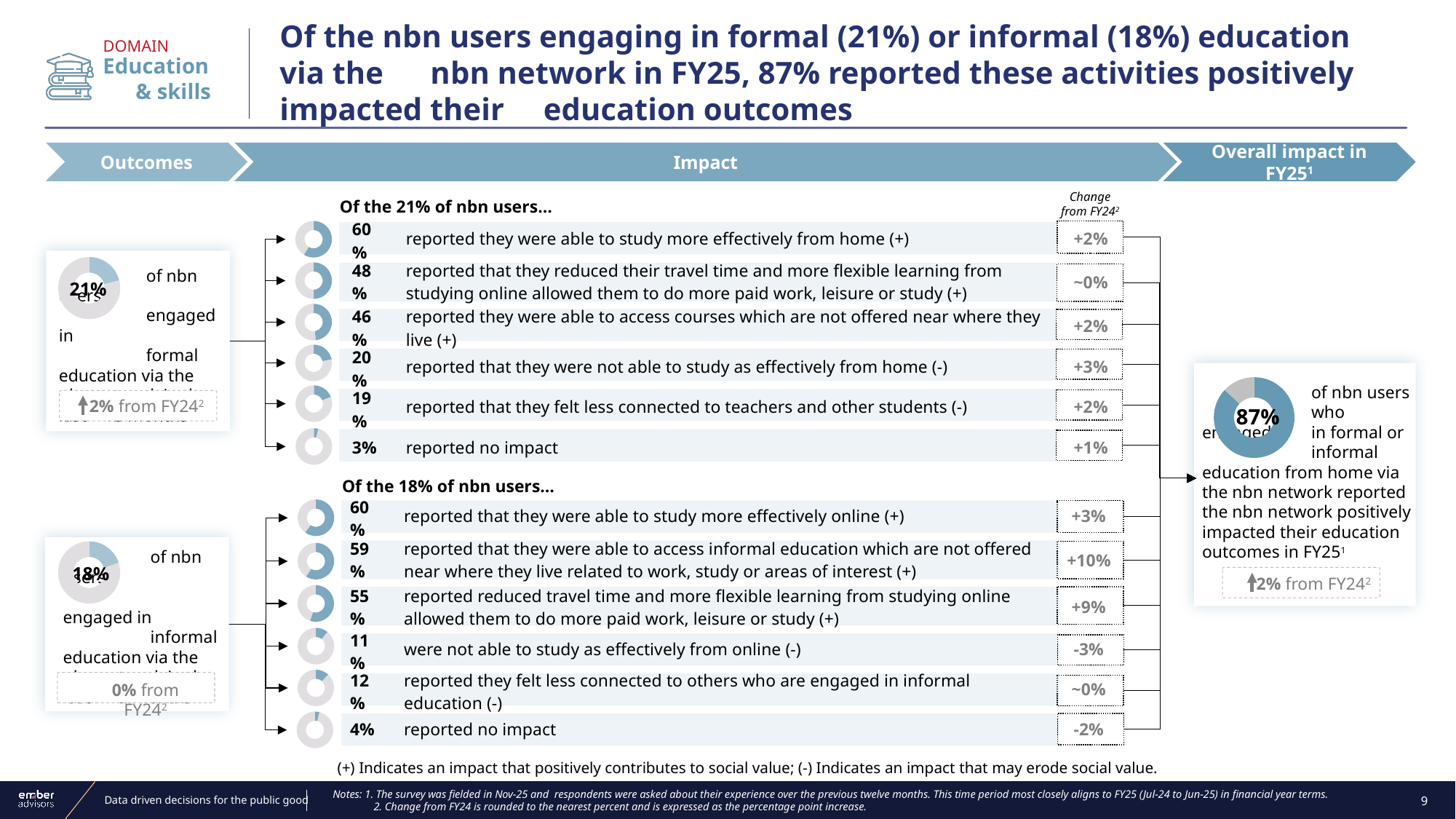
Which is larger: the share of informal education users who were not able to study as effectively online, or the share who felt less connected to others? felt less connected to others (12%) What is the change from FY24 for the 87% overall impact figure? +2% Among the 18% of nbn users in informal education, what percentage reported they were able to access informal education not offered near where they live? 59% What type of chart is used to show the 87% overall impact figure? Donut (pie) chart What percentage of nbn users engaged in informal education via the nbn network, as shown in the lower-left donut chart? 18% In the right-hand donut chart, what share of nbn users engaged in formal or informal education reported the nbn network positively impacted their education outcomes in FY25? 87% Among the 21% of nbn users in formal education, what percentage reported they were able to study more effectively from home? 60% Among the 21% of nbn users in formal education, what percentage reported no impact? 3% Which impact among the 18% of nbn users in informal education has the largest change from FY24? Reported that they were able to access informal education which are not offered near where they live (+10%) How many impact rows (donut charts) are listed for the 18% of nbn users engaged in informal education? 6 What percentage of nbn users engaged in formal education via the nbn network, as shown in the left donut chart? 21% What is the difference between the share of formal education users who reported studying more effectively from home (60%) and those who reported they were not able to study as effectively from home (20%)? 40%